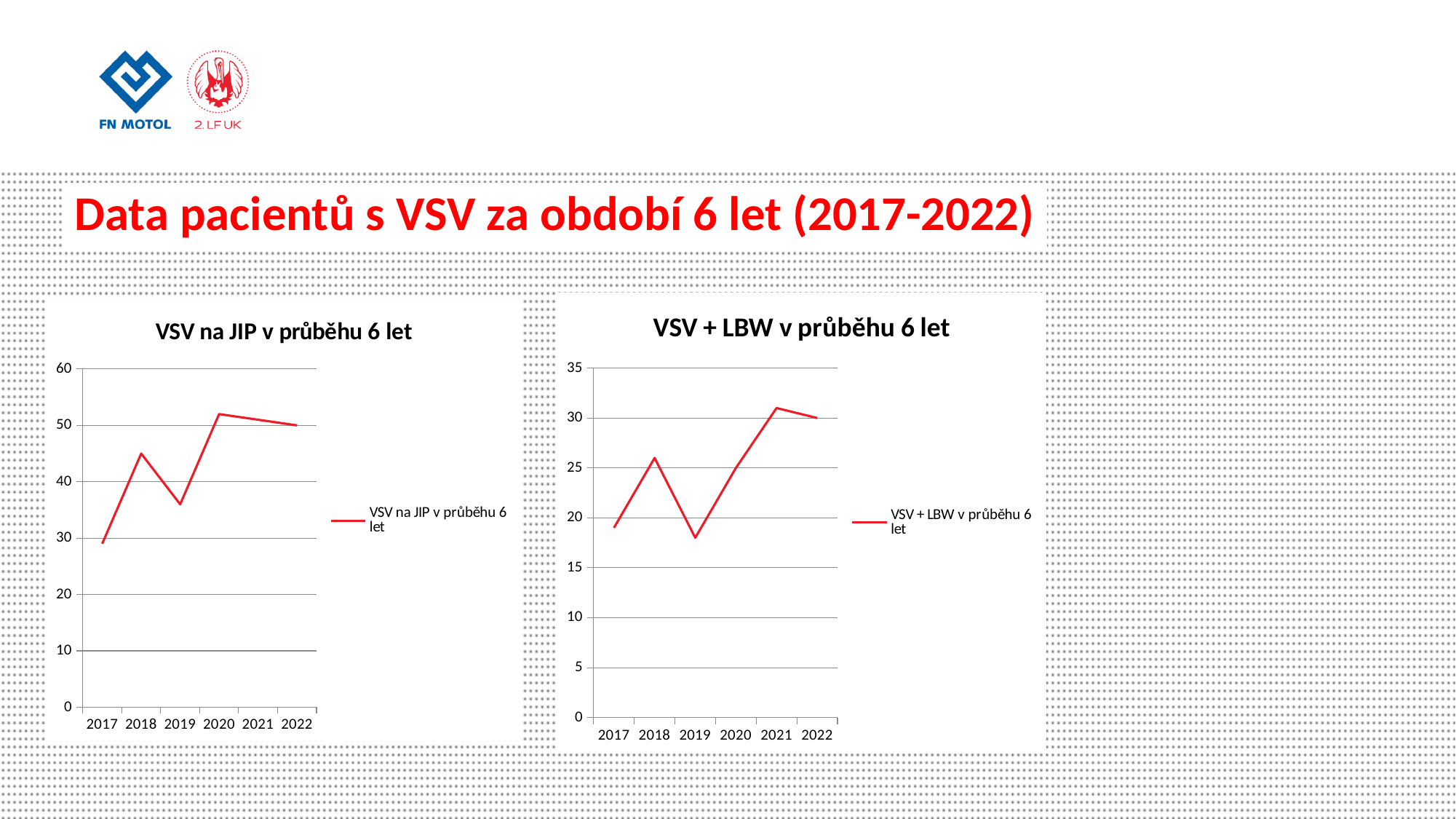
In the 'VSV + LBW v průběhu 6 let' chart, is the value overall higher or lower in 2022 than in 2017? higher In the 'VSV + LBW v průběhu 6 let' chart, is the value for 2021 greater or less than 30? greater In the 'VSV na JIP v průběhu 6 let' chart, is the value for 2019 greater or less than 40? less In the 'VSV na JIP v průběhu 6 let' chart, which is larger, the value for 2018 or the value for 2019? 2018 In the 'VSV na JIP v průběhu 6 let' chart, is the value for 2018 greater or less than 40? greater In the 'VSV na JIP v průběhu 6 let' chart, which year has the lowest value? 2017 What is the title of the chart on the right side of the slide? VSV + LBW v průběhu 6 let What kind of chart is the 'VSV na JIP v průběhu 6 let' chart on the left? line chart In the 'VSV + LBW v průběhu 6 let' chart, which is larger, the value for 2017 or the value for 2020? 2020 In the 'VSV na JIP v průběhu 6 let' chart, how many series does the legend list? 1 In the 'VSV na JIP v průběhu 6 let' chart, how many years are plotted on the x axis? 6